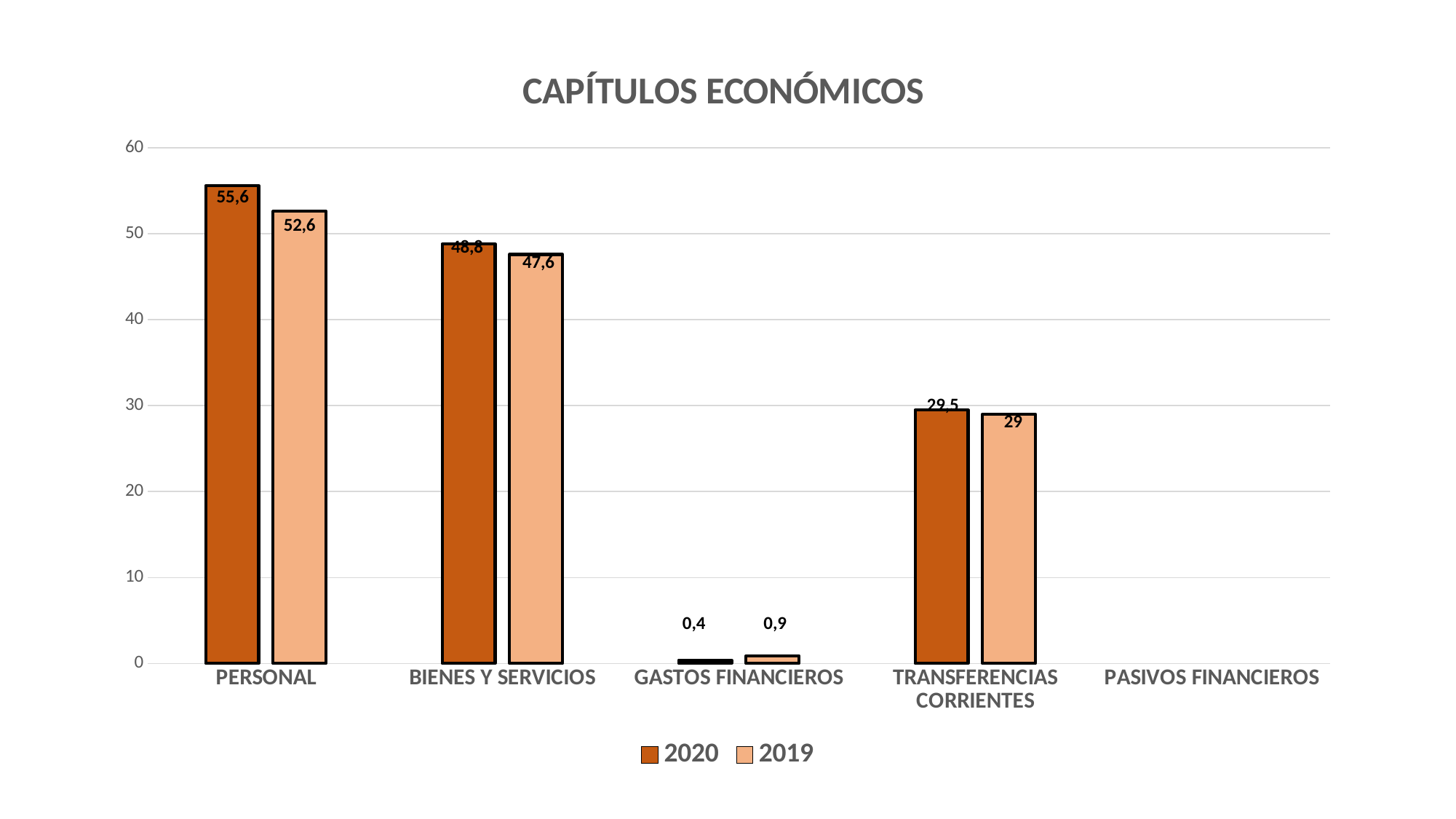
What is the value for PERSONAL in the 2020 series? 55,6 How many series does the legend list? 2 What is the difference between the 2020 and 2019 values for PERSONAL? 3 Is the 2019 value for PERSONAL greater or less than 50? greater Which is larger for GASTOS FINANCIEROS, the 2020 value or the 2019 value? 2019 Which category has the highest value in the 2020 series? PERSONAL What kind of chart is shown on the slide? bar chart What is the value for BIENES Y SERVICIOS in the 2019 series? 47,6 What is the value for TRANSFERENCIAS CORRIENTES in the 2020 series? 29,5 How many categories are shown on the x axis? 5 Which category with a plotted bar has the lowest value in the 2019 series? GASTOS FINANCIEROS What is the value for GASTOS FINANCIEROS in the 2019 series? 0,9